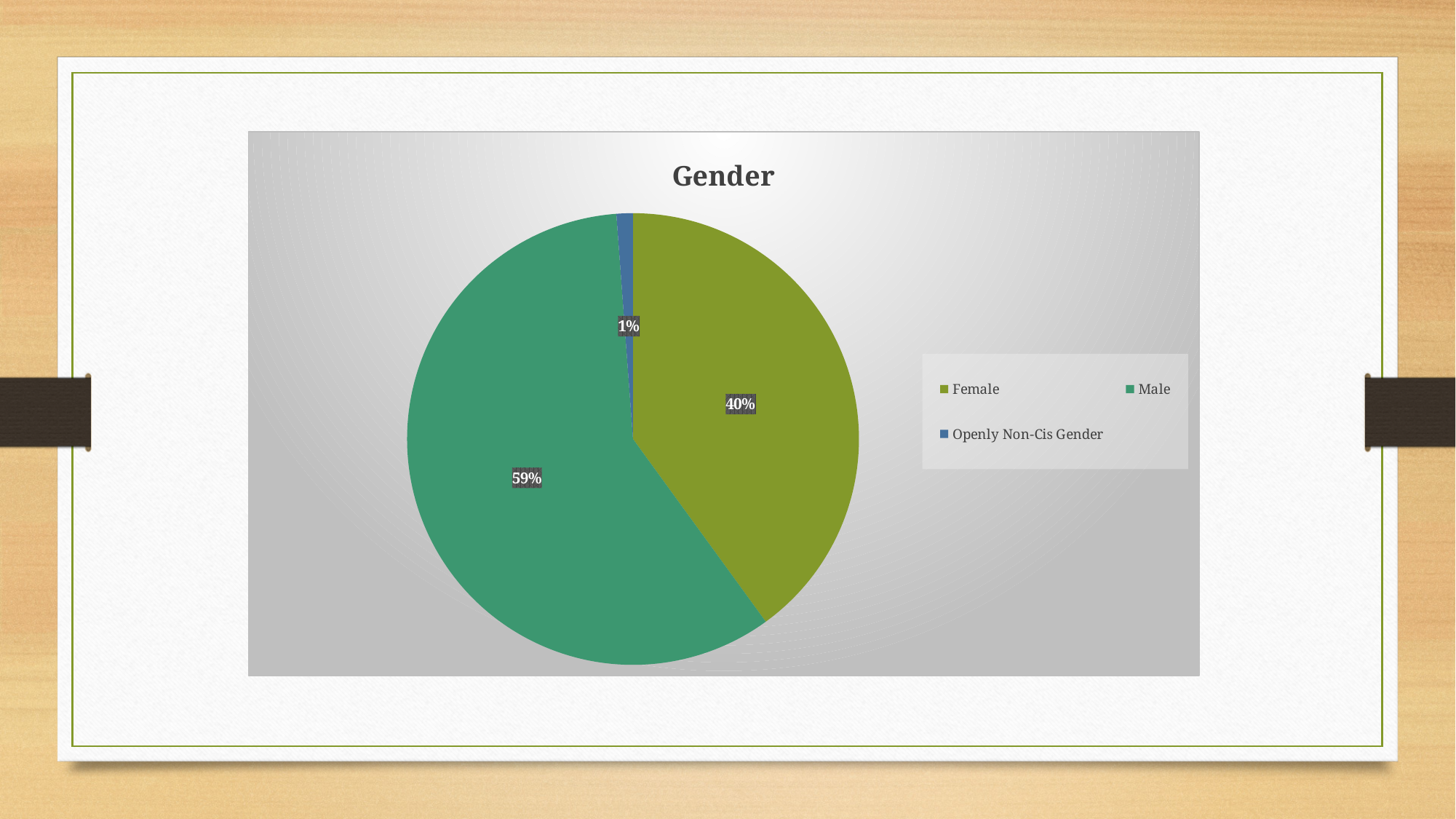
What is the difference in percentage points between the Male and Female shares? 19 What percentage of the pie is Male? 59% Which category is shown in blue in the legend? Openly Non-Cis Gender How many categories does the pie chart show? 3 What percentage of the pie is Openly Non-Cis Gender? 1% What is the title of the chart? Gender Which is larger, the Female share or the Male share? Male What percentage of the pie is Female? 40% Is the Female share greater or less than 50%? less What kind of chart is shown on the slide? Pie chart Which category has the smallest share of the pie? Openly Non-Cis Gender Which category has the largest share of the pie? Male